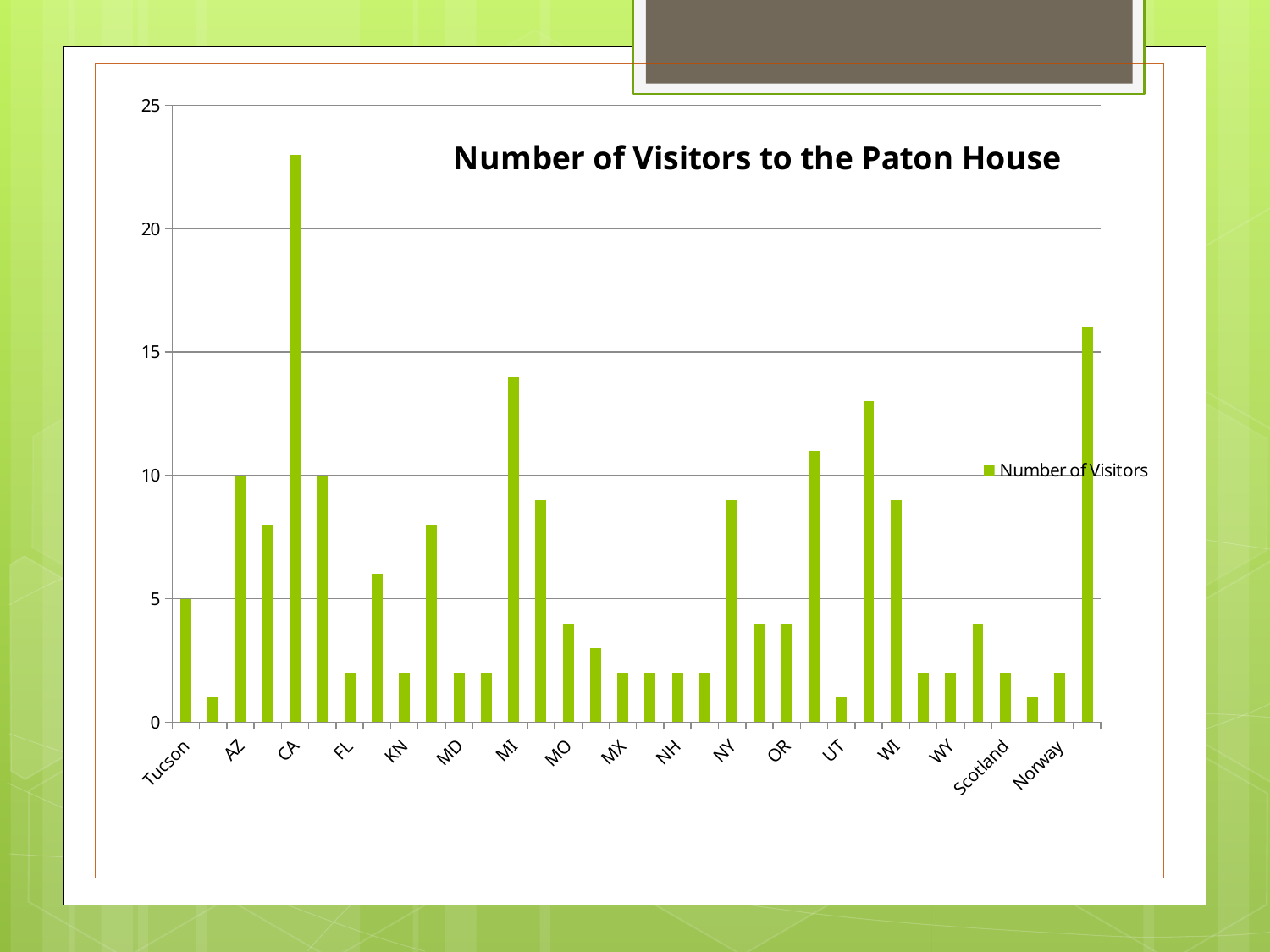
What is the title of the chart? Number of Visitors to the Paton House What is the number of visitors for AZ? 10 Is the value for CA greater or less than 20? greater Is the value for UT greater or less than 5? less How many series does the legend list? 1 What is the number of visitors for Tucson? 5 What is the name of the series shown in the legend? Number of Visitors What kind of chart is shown on the slide? bar chart Which has more visitors, NY or OR? NY Is the value for MI greater or less than 10? greater Which labeled category has the highest number of visitors? CA Which has more visitors, CA or MI? CA